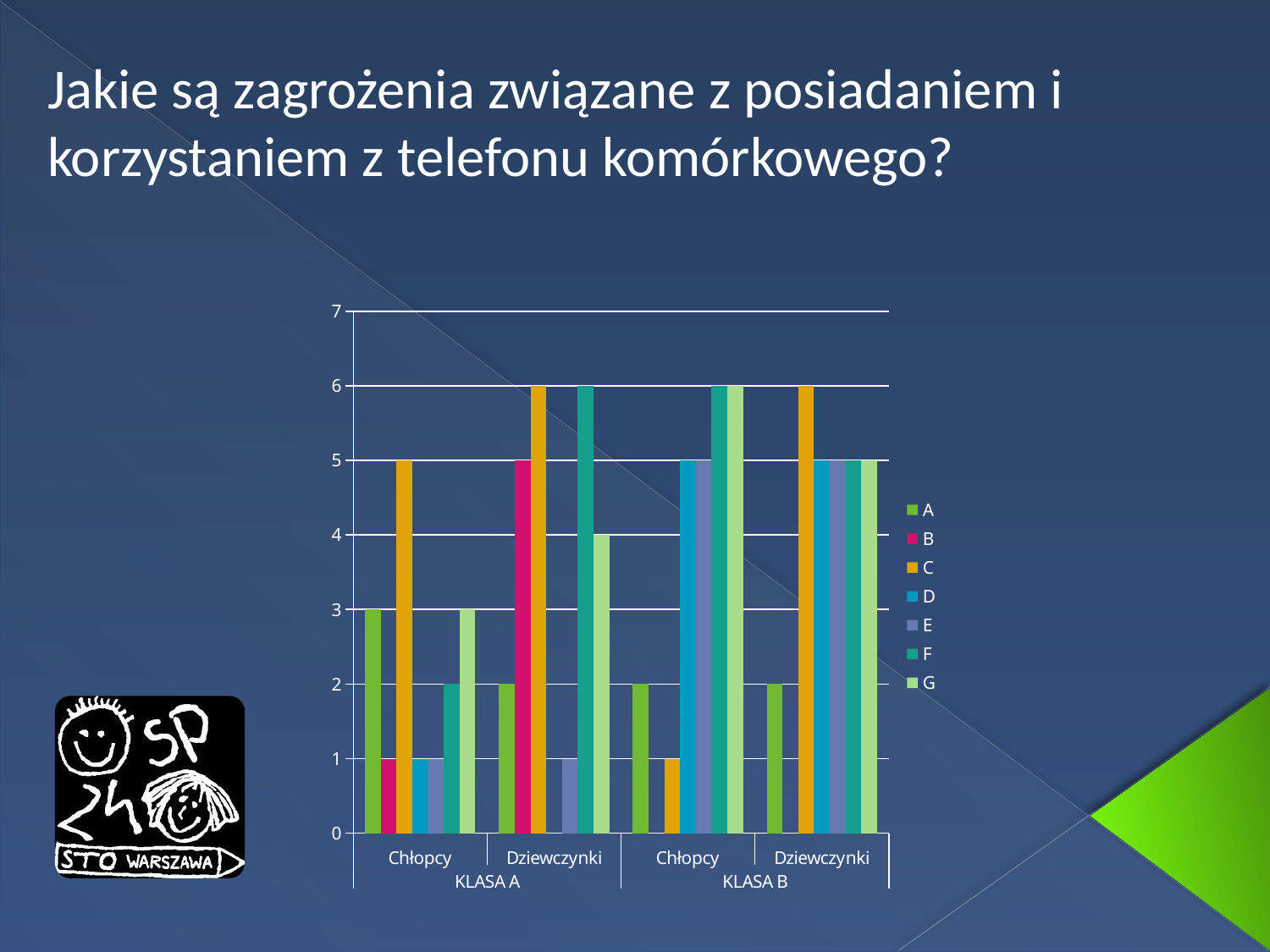
How many series does the legend list? 7 What kind of chart is shown on the slide? bar chart What is the value of series A for Chłopcy in KLASA A? 3 What is the value of series B for Dziewczynki in KLASA A? 5 What is the value of series C for Chłopcy in KLASA A? 5 What is the difference between series C and series A for Chłopcy in KLASA A? 2 Which series has the highest value for Chłopcy in KLASA A? C What is the highest value shown on the vertical axis? 7 What is the value of series C for Chłopcy in KLASA B? 1 What is the value of series G for Dziewczynki in KLASA A? 4 Which is larger for Chłopcy in KLASA B: series D or series F? F